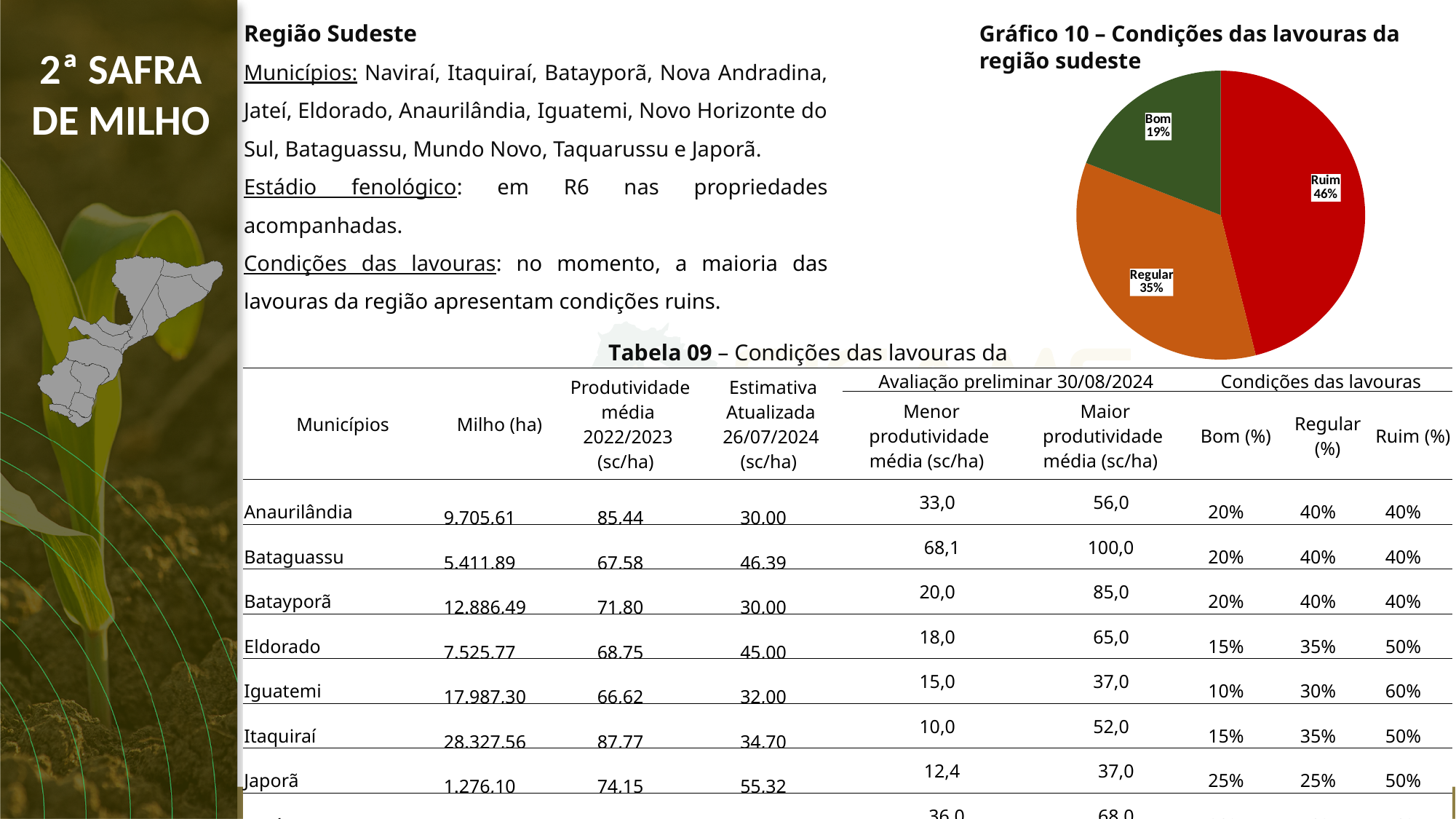
Which slice is larger, Regular or Bom? Regular Which category has the largest slice in the pie chart? Ruim What share of the pie chart does the Regular slice represent? 35% What type of chart is shown on the slide? Pie chart What is the difference in percentage points between the Ruim and Bom slices? 27 Which slice is larger, Ruim or Regular? Ruim How many slices does the pie chart have? 3 What share of the pie chart does the Ruim slice represent? 46% Which category has the smallest slice in the pie chart? Bom What share of the pie chart does the Bom slice represent? 19% What is the title of the chart on the slide? Gráfico 10 – Condições das lavouras da região sudeste What is the difference in percentage points between the Regular and Bom slices? 16